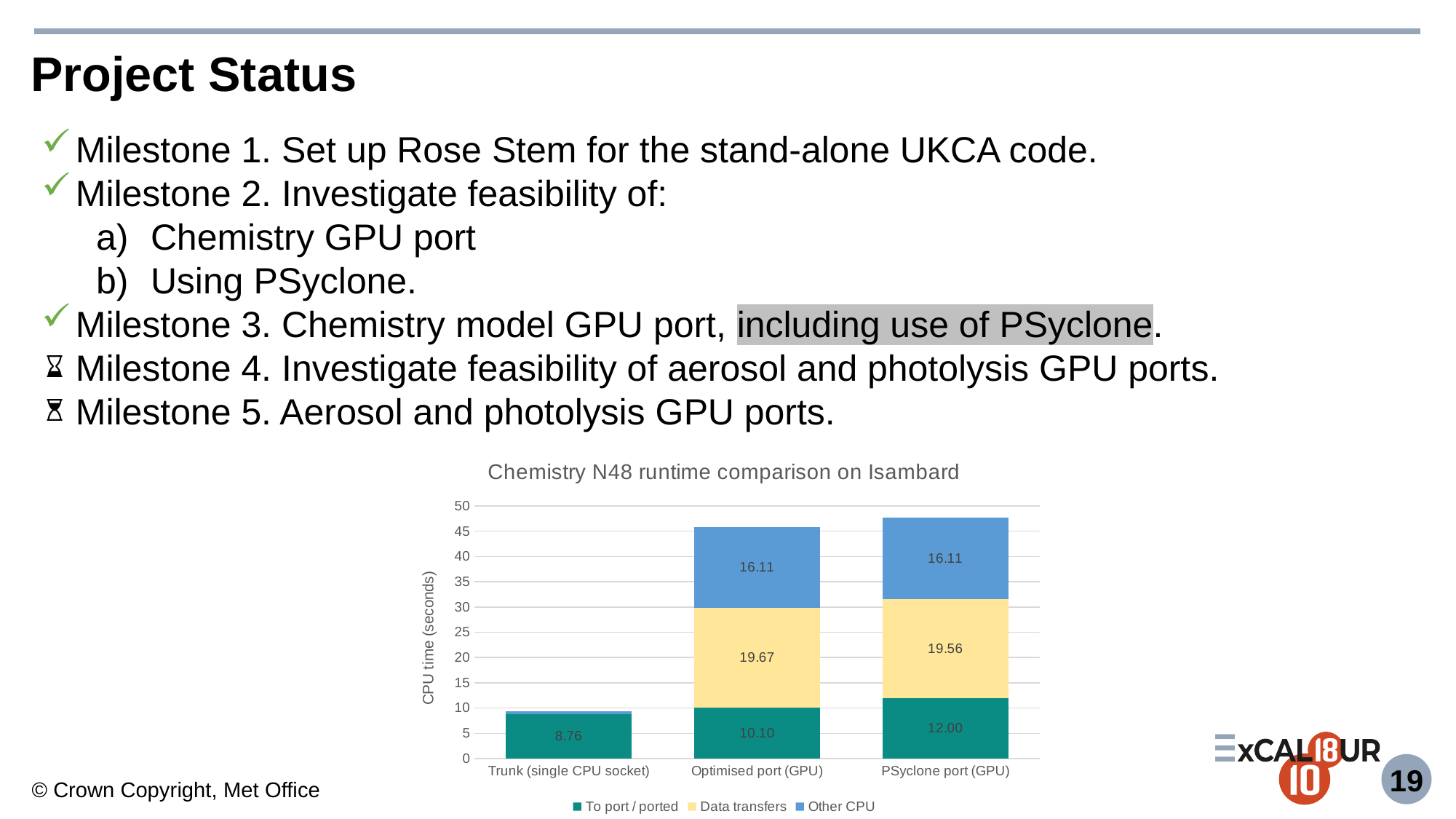
What is the 'To port / ported' value for Optimised port (GPU)? 10.10 How many categories are shown on the x axis? 3 What is the 'Other CPU' value for Optimised port (GPU)? 16.11 What is the 'To port / ported' value for Trunk (single CPU socket)? 8.76 What is the total stacked value for Optimised port (GPU)? 45.88 What is the 'Data transfers' value for PSyclone port (GPU)? 19.56 Is the total stacked value for Trunk (single CPU socket) greater or less than 10? less What is the difference between the 'To port / ported' values for PSyclone port (GPU) and Optimised port (GPU)? 1.90 How many series does the legend list? 3 What kind of chart is shown on the slide? stacked bar chart Which category has the highest 'To port / ported' value? PSyclone port (GPU) Which has the larger 'Data transfers' value, Optimised port (GPU) or PSyclone port (GPU)? Optimised port (GPU)